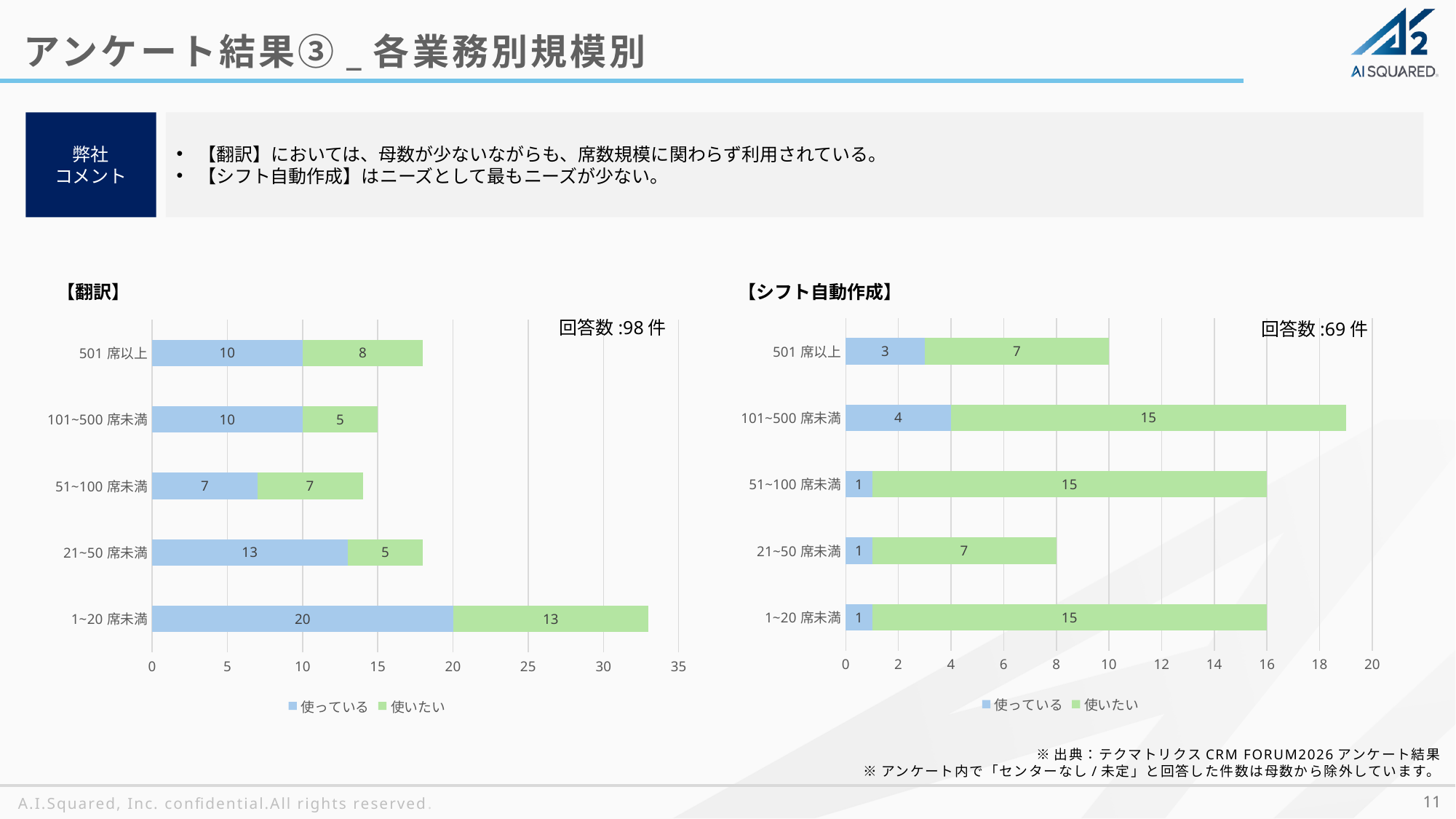
In the 【翻訳】 chart, which category has the highest 使っている value? 1~20席未満 How many series does the legend of the 【シフト自動作成】 chart list? 2 In the 【シフト自動作成】 chart, which category has the lowest 使いたい value? 21~50席未満 and 501席以上 (both 7) In the 【翻訳】 chart, what is the difference between the 使っている values for 21~50席未満 and 51~100席未満? 6 In the 【シフト自動作成】 chart, what is the value of 使いたい for 101~500席未満? 15 In the 【シフト自動作成】 chart, what is the value of 使っている for 501席以上? 3 How many categories does the 【翻訳】 chart show? 5 In the 【シフト自動作成】 chart, what is the total of the stacked bar for 101~500席未満? 19 In the 【シフト自動作成】 chart, which is larger: 使いたい for 21~50席未満 or 使いたい for 51~100席未満? 51~100席未満 In the 【翻訳】 chart, what is the value of 使っている for 1~20席未満? 20 In the 【翻訳】 chart, what is the value of 使いたい for 501席以上? 8 In the 【翻訳】 chart, what is the total of the stacked bar for 1~20席未満? 33